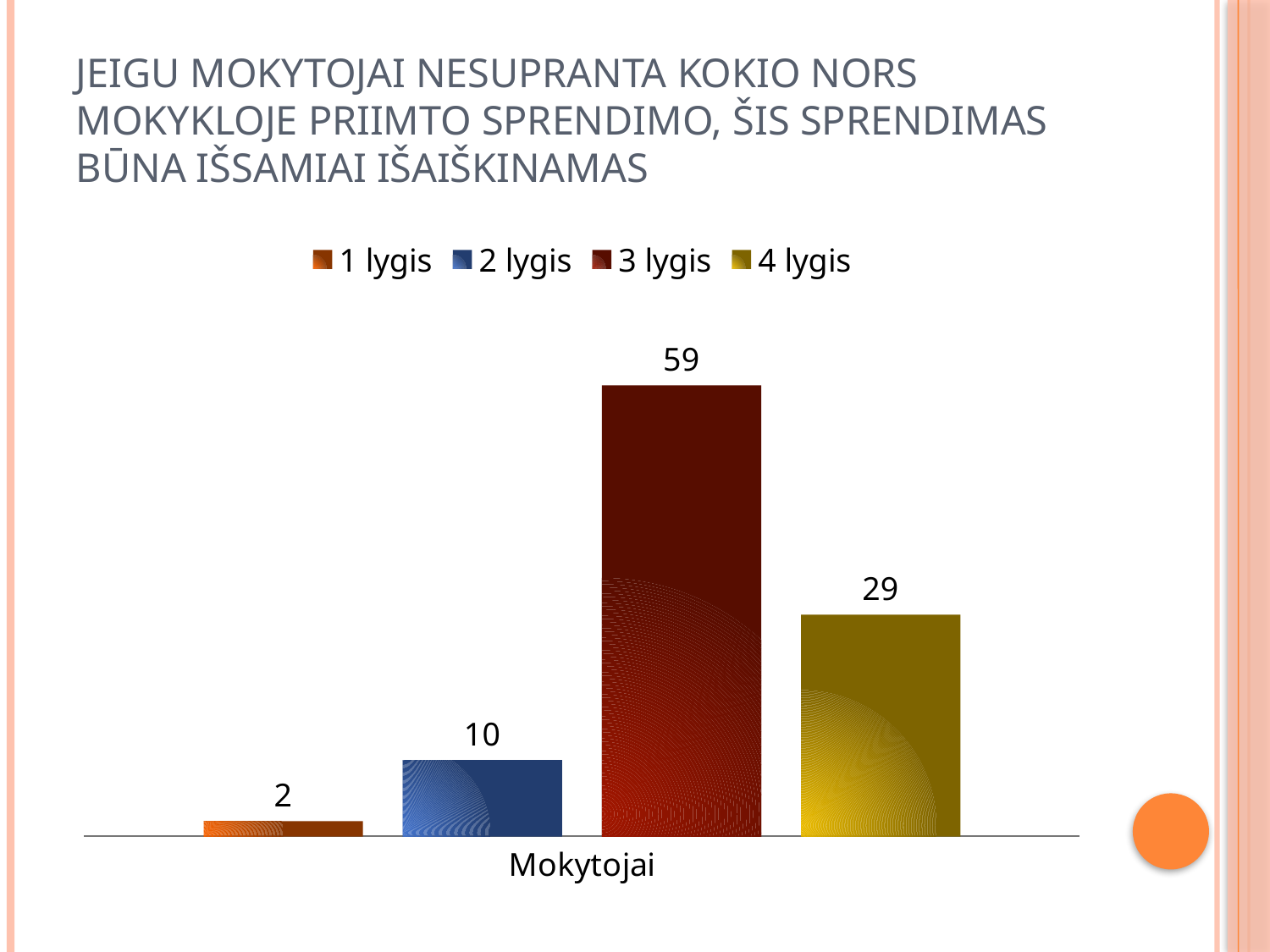
Which is larger, the value for 4 lygis or the value for 2 lygis? 4 lygis Which series has the highest value? 3 lygis Which series has the lowest value? 1 lygis What kind of chart is shown on the slide? bar chart What is the difference between the values for 3 lygis and 4 lygis? 30 What is the value for 4 lygis? 29 What is the category label shown on the x axis? Mokytojai What is the value for 2 lygis? 10 What is the difference between the values for 2 lygis and 1 lygis? 8 What is the value for 3 lygis? 59 How many series does the legend list? 4 What is the value for 1 lygis? 2